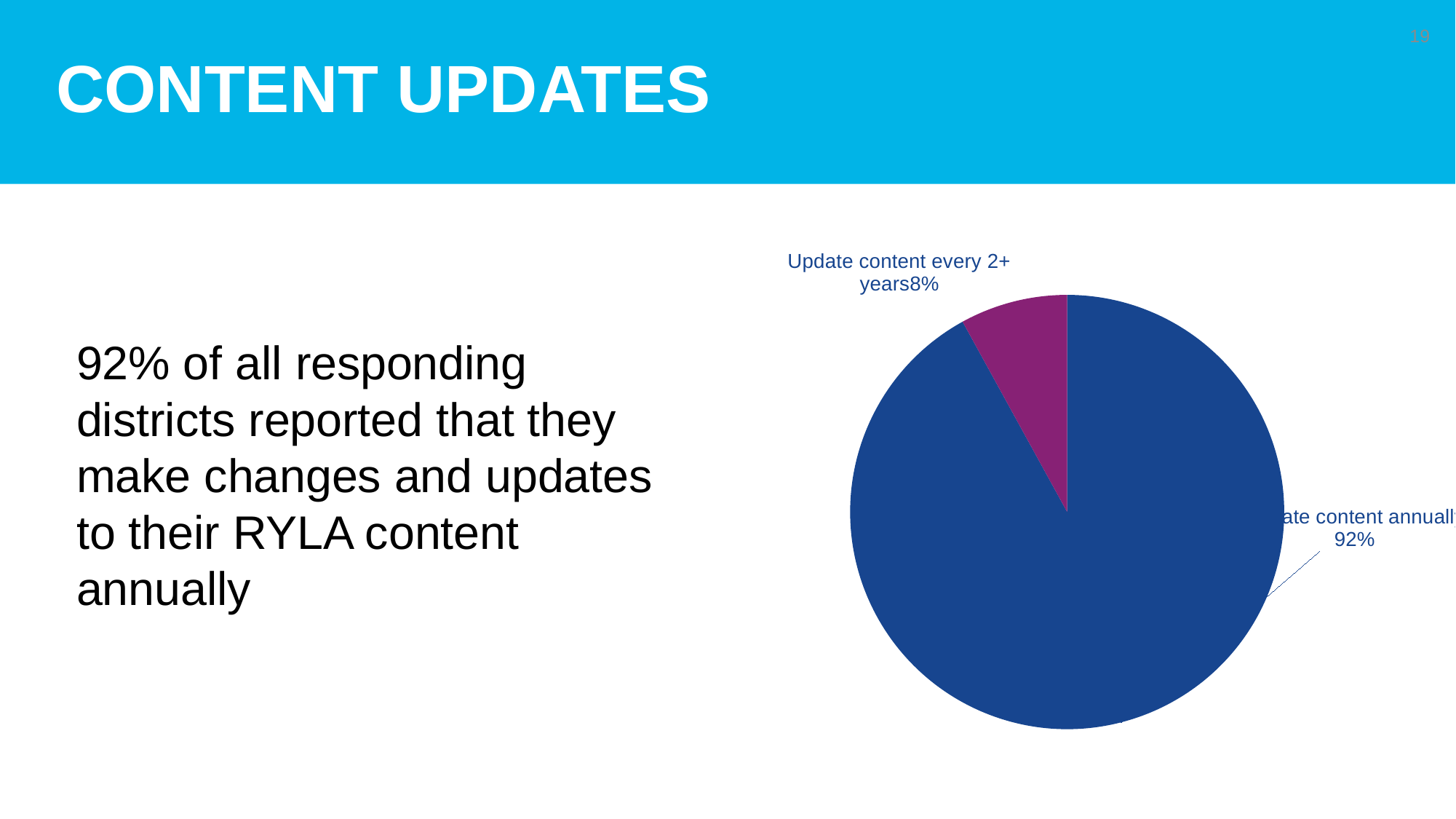
Which is larger: the share for "Update content annually" or the share for "Update content every 2+ years"? Update content annually How many slices does the pie chart have? 2 What colour is the "Update content annually" slice? blue What share of the pie is labelled "Update content annually"? 92% Which slice of the pie chart is the smallest? Update content every 2+ years Which slice of the pie chart is the largest? Update content annually What colour is the "Update content every 2+ years" slice? purple What share of the pie is labelled "Update content every 2+ years"? 8% What is the difference in percentage points between the "Update content annually" slice and the "Update content every 2+ years" slice? 84 What kind of chart is shown on the slide? pie chart